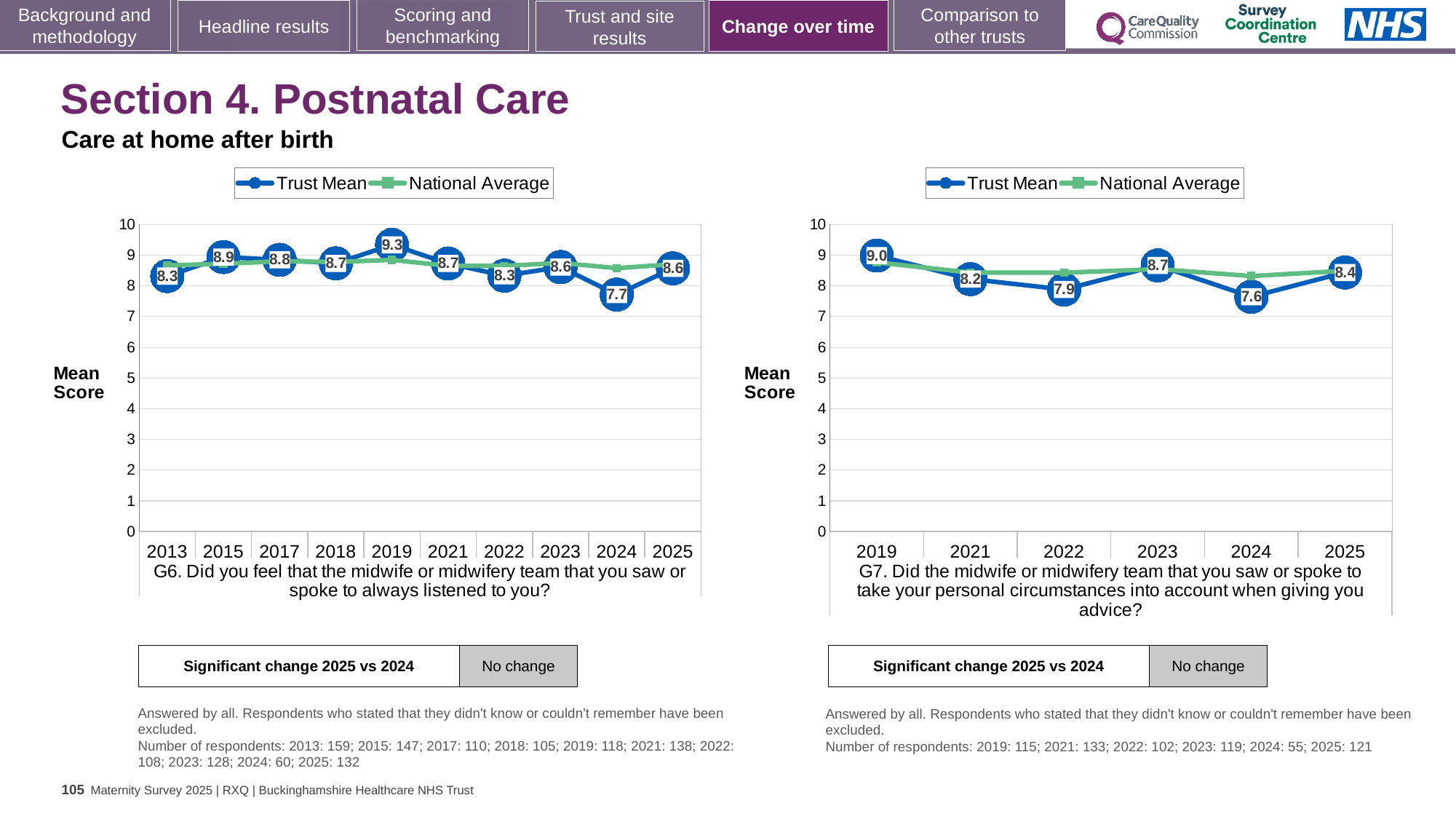
What type of chart is used on the left of the slide (G6)? Line chart In the left chart (G6), which year has the highest Trust Mean? 2019 In the left chart (G6), what is the Trust Mean for 2024? 7.7 In the left chart (G6), which year has the lowest Trust Mean? 2024 In the right chart (G7), what is the Trust Mean for 2022? 7.9 In the right chart (G7), which year has the highest Trust Mean? 2019 In the right chart (G7), which year has the lowest Trust Mean? 2024 In the left chart (G6), what is the Trust Mean for 2019? 9.3 In the right chart (G7), is the Trust Mean higher in 2023 or in 2025? 2023 In the left chart (G6), how many years are plotted on the x axis? 10 In the right chart (G7), how many series does the legend list? 2 In the left chart (G6), what is the difference between the Trust Mean in 2019 and in 2024? 1.6